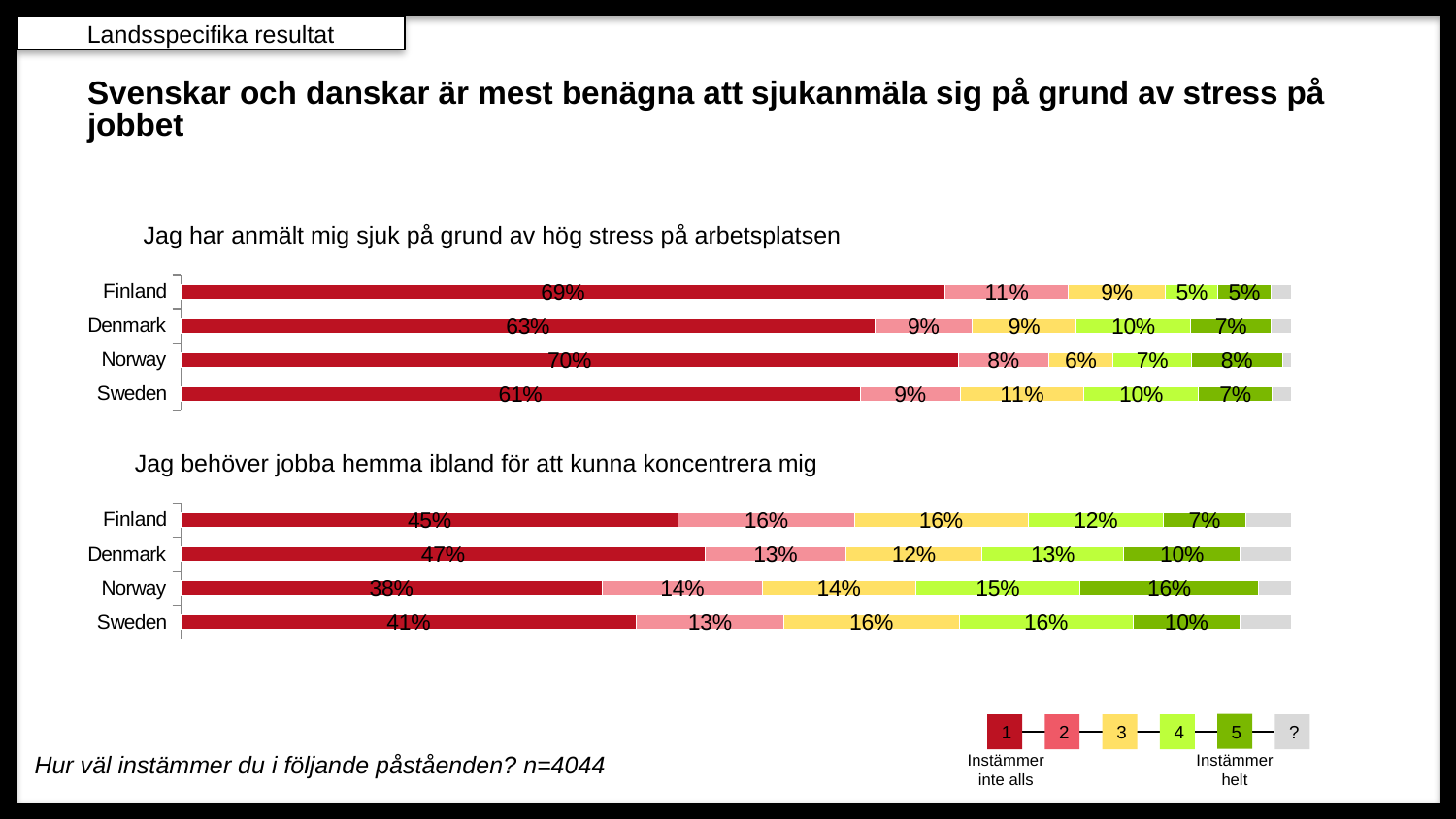
How many categories does the legend at the bottom of the slide list? 6 In the top chart ("Jag har anmält mig sjuk på grund av hög stress på arbetsplatsen"), what percentage of respondents in Norway chose 1 (Instämmer inte alls)? 70% In the top chart ("Jag har anmält mig sjuk på grund av hög stress på arbetsplatsen"), what percentage of respondents in Sweden chose 3? 11% In the bottom chart ("Jag behöver jobba hemma ibland för att kunna koncentrera mig"), what percentage of respondents in Norway chose 5 (Instämmer helt)? 16% What type of chart is used on the slide? Stacked horizontal bar chart How many countries are shown in each chart on the slide? 4 In the top chart ("Jag har anmält mig sjuk på grund av hög stress på arbetsplatsen"), which country has the highest share for 1 (Instämmer inte alls)? Norway In the bottom chart ("Jag behöver jobba hemma ibland för att kunna koncentrera mig"), which is larger: Finland's share for 1 or Sweden's share for 1? Finland In the top chart ("Jag har anmält mig sjuk på grund av hög stress på arbetsplatsen"), what is the difference between Norway's and Sweden's share for 1 (Instämmer inte alls)? 9 percentage points In the bottom chart ("Jag behöver jobba hemma ibland för att kunna koncentrera mig"), what is the difference between Denmark's and Norway's share for 1 (Instämmer inte alls)? 9 percentage points In the top chart ("Jag har anmält mig sjuk på grund av hög stress på arbetsplatsen"), which country has the lowest share for 1 (Instämmer inte alls)? Sweden In the bottom chart ("Jag behöver jobba hemma ibland för att kunna koncentrera mig"), which country has the highest share for 1 (Instämmer inte alls)? Denmark